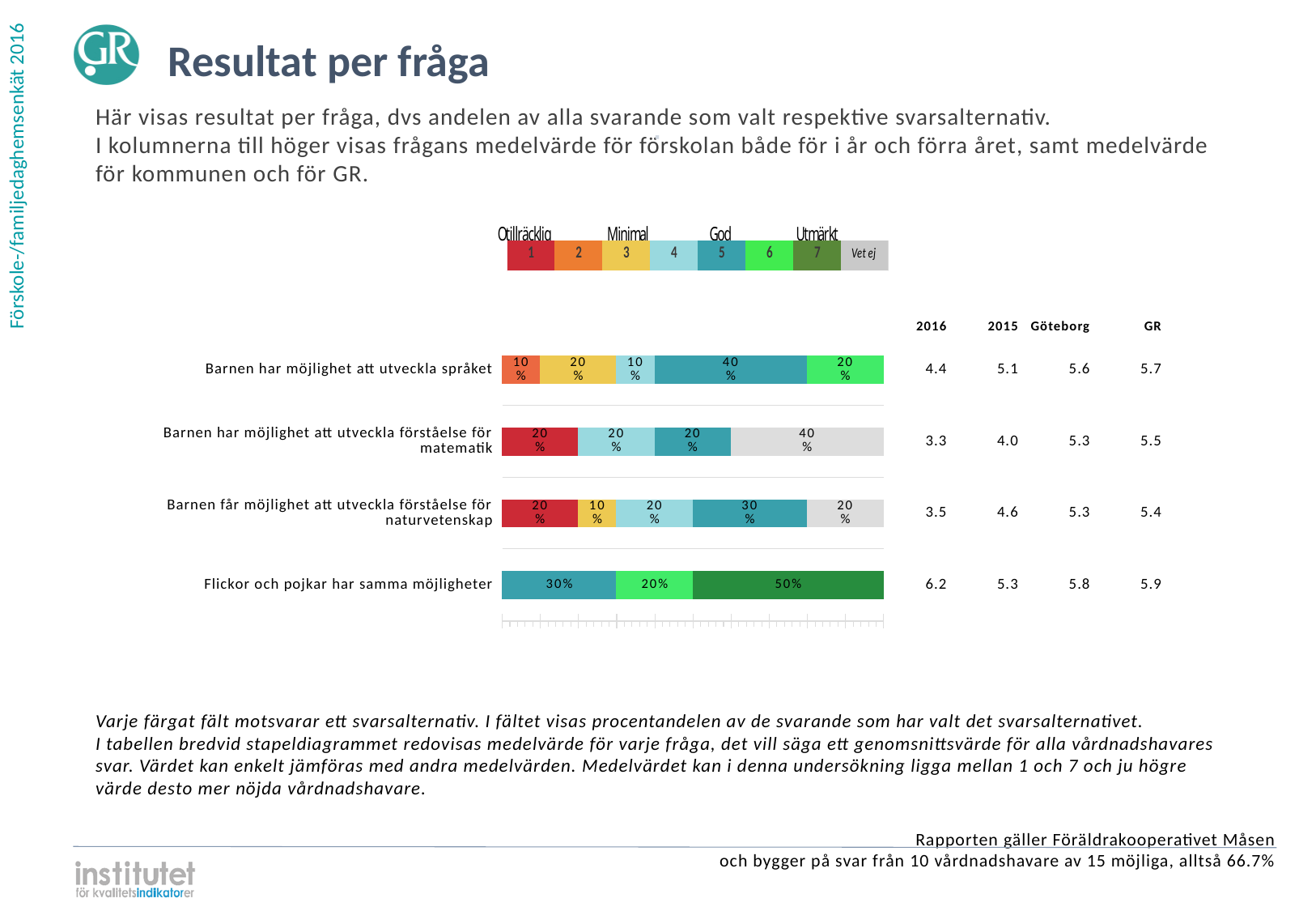
Which question has the lowest 2016 mean value in the table next to the chart? Barnen har möjlighet att utveckla förståelse för matematik How many questions (categories) are plotted in the bar chart? 4 How many response options does the legend above the chart list, including 'Vet ej'? 8 For 'Barnen har möjlighet att utveckla språket', which is larger: the option 3 (yellow) share or the option 4 (light blue) share? Option 3 (yellow), 20% Which question has the largest single segment in its bar? Flickor och pojkar har samma möjligheter What is the 2016 mean value shown for 'Flickor och pojkar har samma möjligheter'? 6.2 What is the difference between the option 5 (teal) share and the option 3 (yellow) share for 'Barnen får möjlighet att utveckla förståelse för naturvetenskap'? 20% What percentage of respondents chose option 5 (teal) for 'Barnen har möjlighet att utveckla språket'? 40% What percentage of respondents answered 'Vet ej' (grey) for 'Barnen har möjlighet att utveckla förståelse för matematik'? 40% What percentage of respondents chose option 7 (dark green) for 'Flickor och pojkar har samma möjligheter'? 50% What is the GR mean value shown for 'Barnen har möjlighet att utveckla förståelse för matematik'? 5.5 What kind of chart is shown on the slide? Stacked bar chart